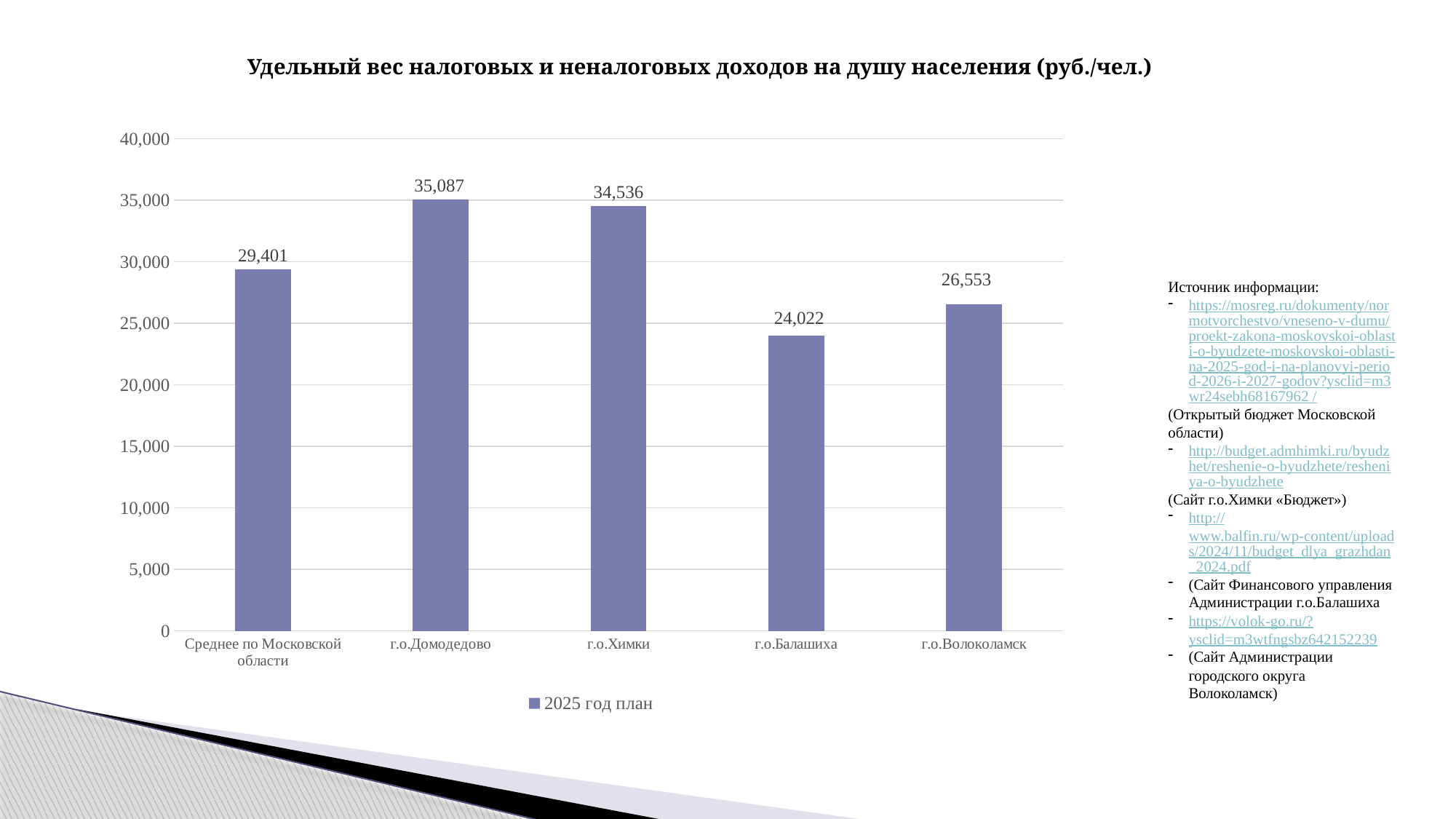
What is the value for Среднее по Московской области? 29,401 What is the difference between the values for г.о.Домодедово and г.о.Химки? 551 Is the value for г.о.Волоколамск greater or less than 25,000? greater What is the difference between the values for г.о.Волоколамск and г.о.Балашиха? 2,531 What kind of chart is shown on the slide? bar chart Which category has the lowest value? г.о.Балашиха Which category has the highest value? г.о.Домодедово What is the value for г.о.Домодедово? 35,087 What is the value for г.о.Балашиха? 24,022 How many series does the legend list? 1 How many categories are shown on the x axis? 5 Which is larger, the value for г.о.Химки or the value for Среднее по Московской области? г.о.Химки